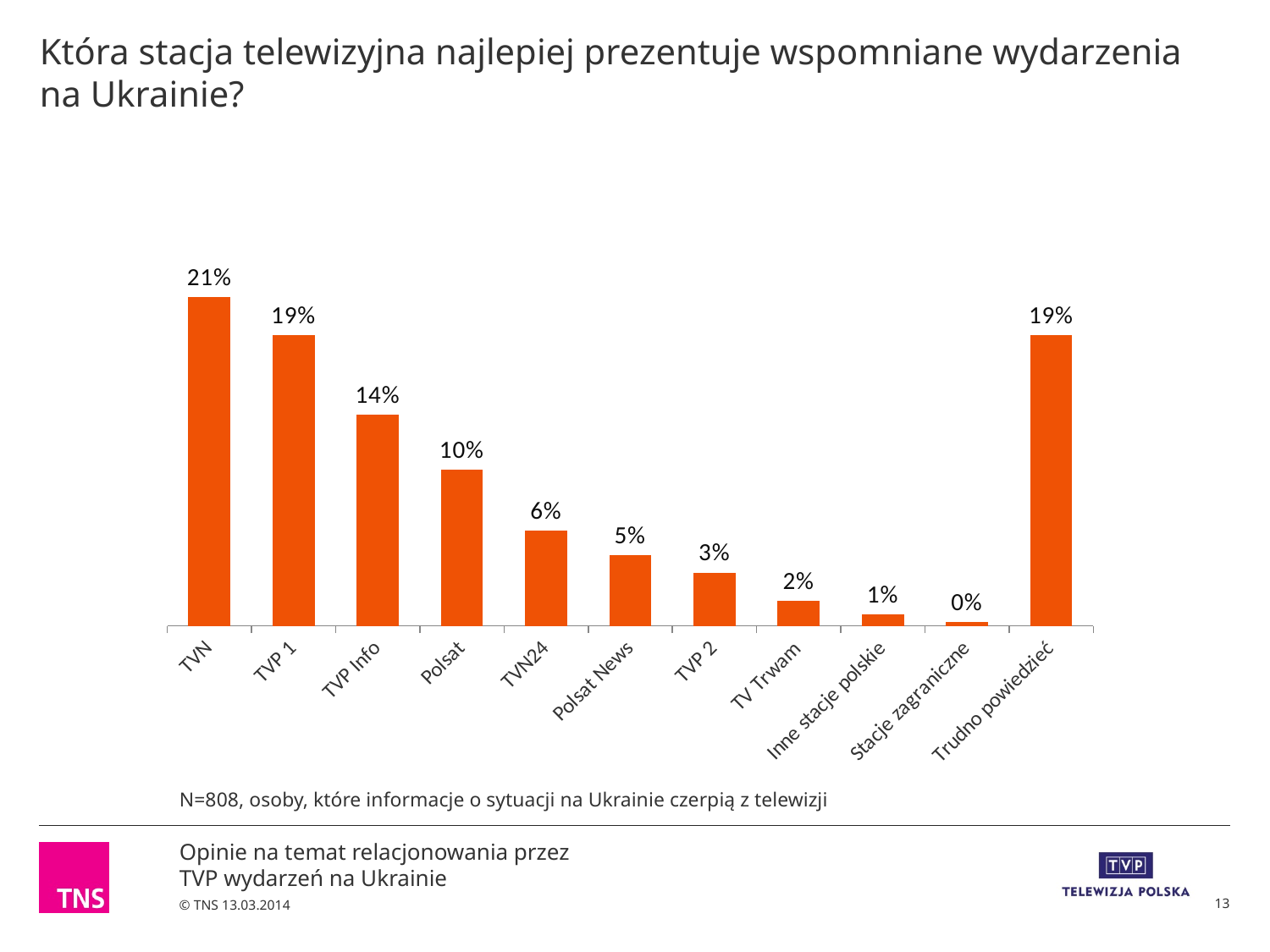
What is the sample size (N) stated below the chart? N=808 What is the difference between the values for Polsat and TVN24? 4% What is the value for TVN? 21% Which category has the lowest value? Stacje zagraniczne What is the value for Trudno powiedzieć? 19% Which is larger, the value for TVP 2 or the value for TV Trwam? TVP 2 What is the value for TVP Info? 14% What kind of chart is shown on the slide? bar chart What is the difference between the values for TVN and TVP 1? 2% Which category has the highest value? TVN How many categories are shown on the x axis? 11 What is the value for Polsat News? 5%